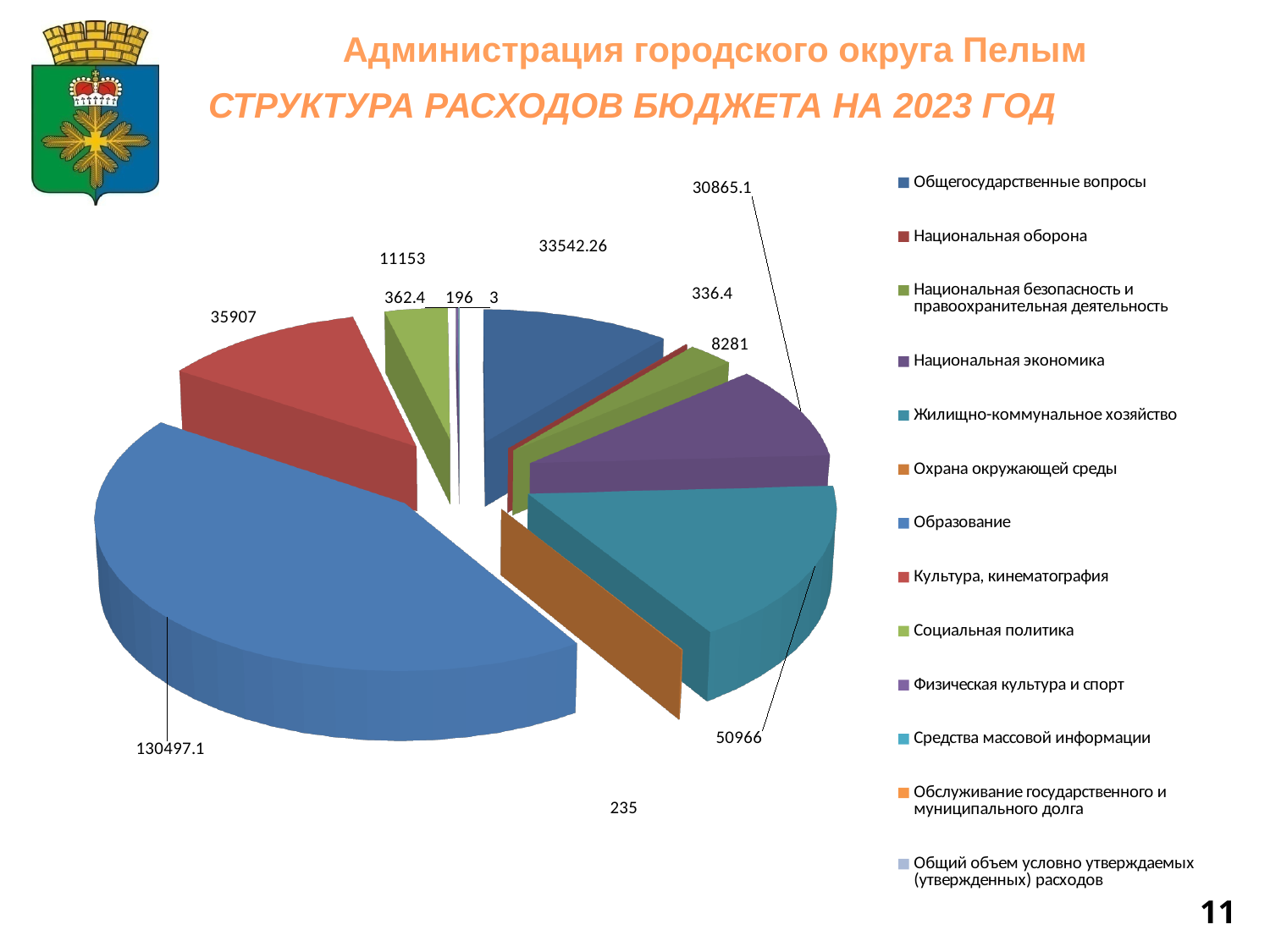
Which category has the largest slice of the pie? Образование What is the difference between the values for Образование and Жилищно-коммунальное хозяйство? 79531.1 What is the value shown for Национальная экономика? 30865.1 How many categories does the legend of the pie chart list? 13 What is the value shown for Социальная политика? 11153 Which is larger, Жилищно-коммунальное хозяйство or Культура, кинематография? Жилищно-коммунальное хозяйство What is the value shown for Образование? 130497.1 What is the value shown for Общегосударственные вопросы? 33542.26 What is the value shown for Жилищно-коммунальное хозяйство? 50966 What is the value shown for Национальная безопасность и правоохранительная деятельность? 8281 What kind of chart is shown on the slide? pie chart What is the value shown for Культура, кинематография? 35907